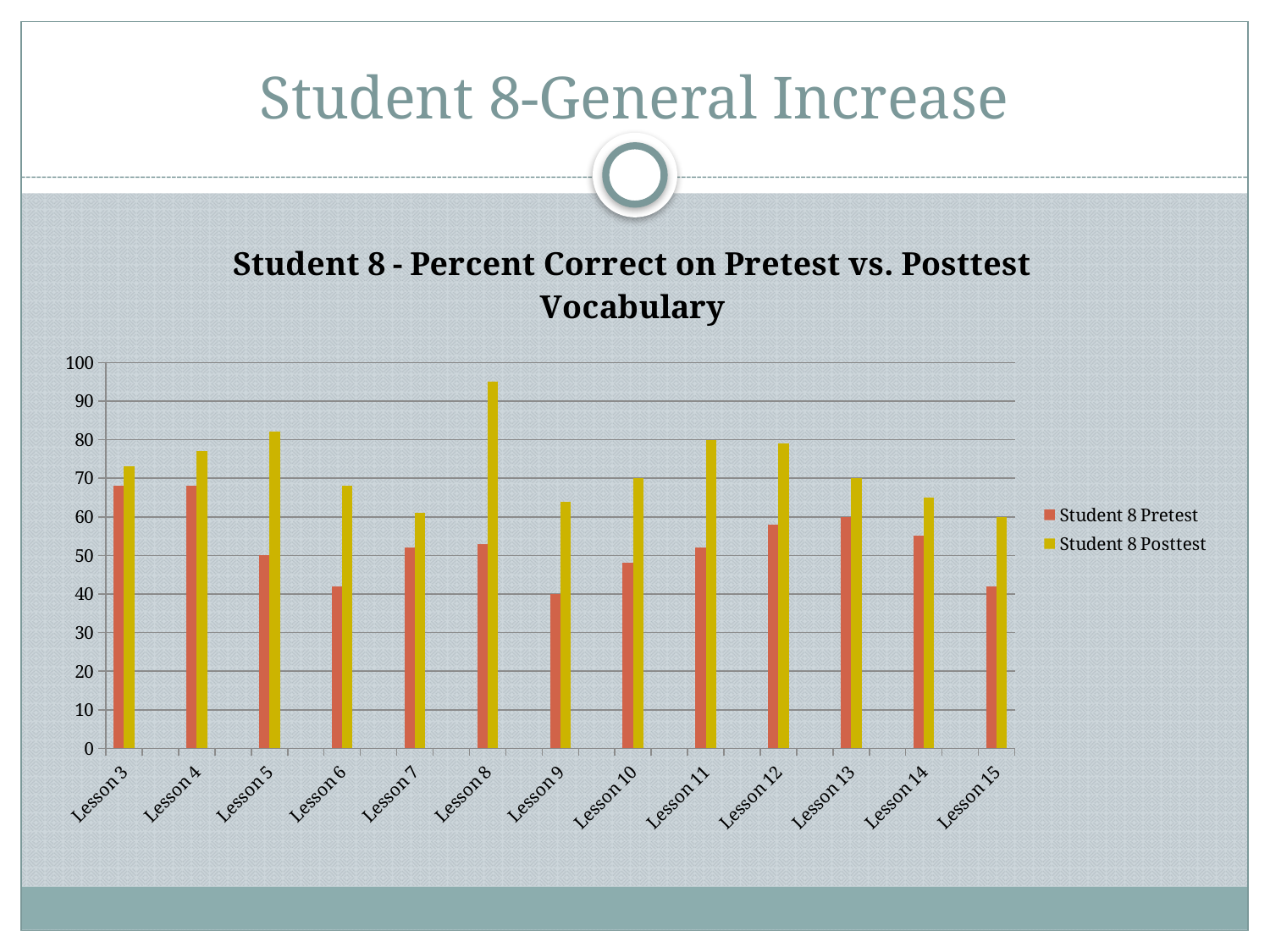
What is the Student 8 Pretest value for Lesson 13? 60 Is the Student 8 Posttest value for Lesson 8 greater or less than 90? greater Which series is shown in yellow in the chart? Student 8 Posttest Which is larger: the Student 8 Posttest value for Lesson 8 or for Lesson 3? Lesson 8 What is the title of the chart? Student 8 - Percent Correct on Pretest vs. Posttest Vocabulary What is the Student 8 Posttest value for Lesson 11? 80 How many lessons are shown on the x axis of the chart? 13 Which lesson has the highest Student 8 Posttest value? Lesson 8 How many series does the chart's legend list? 2 Is the Student 8 Pretest value for Lesson 6 greater or less than 50? less What is the Student 8 Pretest value for Lesson 5? 50 What type of chart is shown on the slide? Bar chart